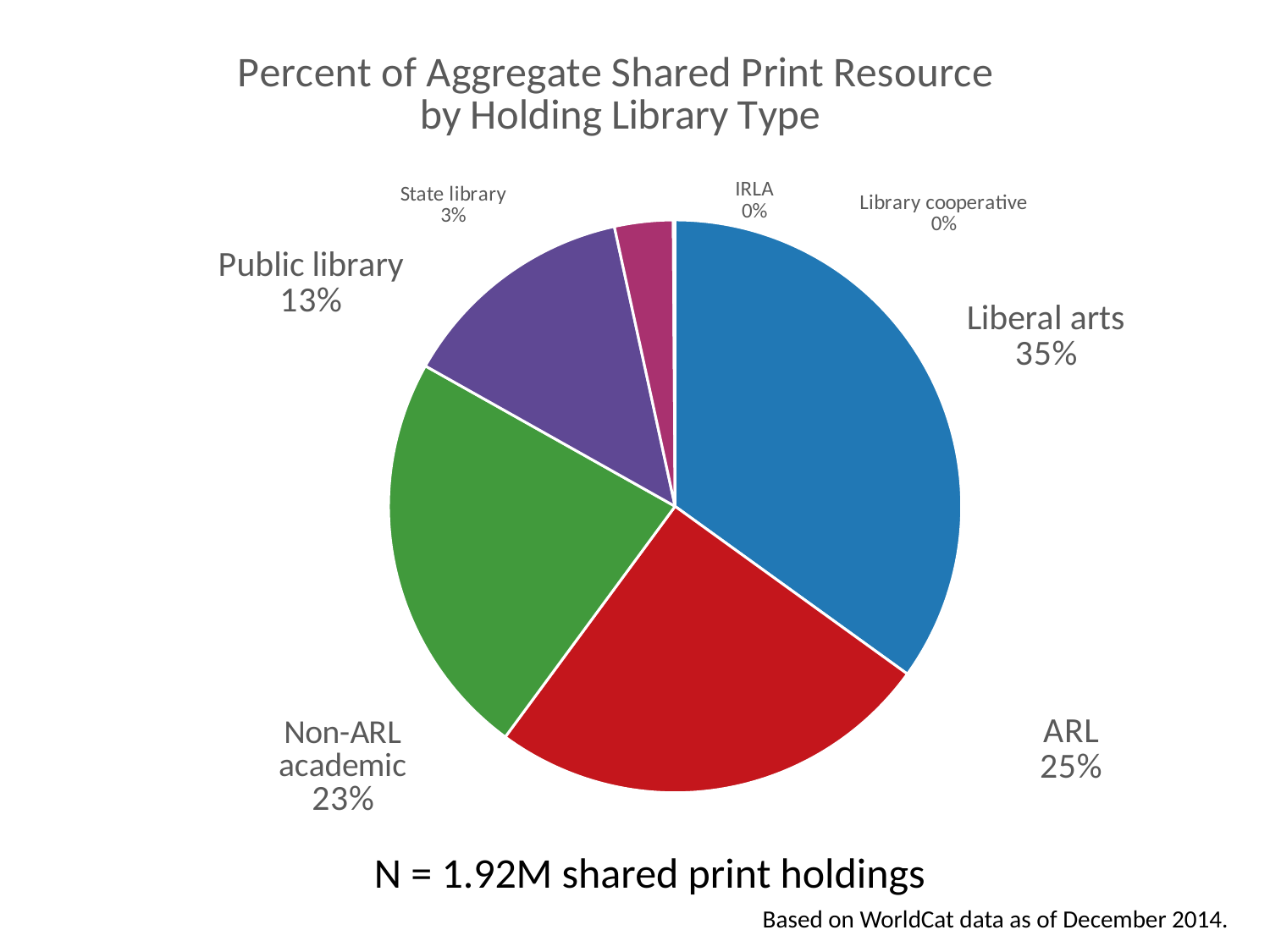
Which of the labelled slices is larger, ARL or Non-ARL academic? ARL How many library types are labelled on the pie chart? 7 What is the title of the chart? Percent of Aggregate Shared Print Resource by Holding Library Type What percentage is shown for Public library? 13% What percentage is shown for State library? 3% What is the total number of shared print holdings (N) stated on the slide? 1.92M What percentage is shown for Non-ARL academic? 23% What percentage is shown for ARL? 25% What percentage of the aggregate shared print resource is held by Liberal arts libraries? 35% What kind of chart is shown on the slide? pie chart What is the difference in percentage points between Liberal arts and Public library? 22 Which holding library type has the largest share of the pie? Liberal arts